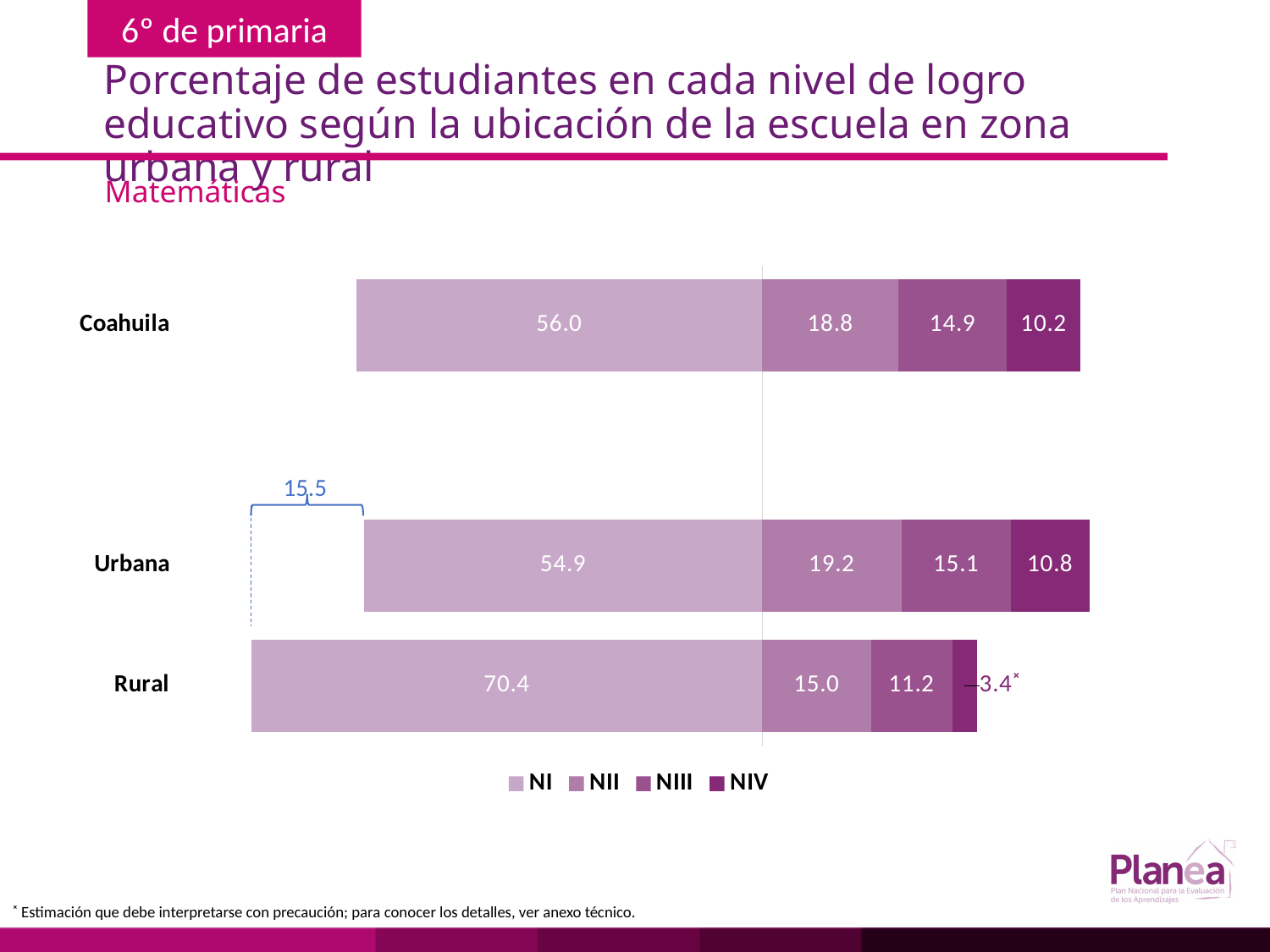
Which category has the highest NI value? Rural What is the difference between the NIV values for Urbana and Rural? 7.4 What is the NII value for Coahuila? 18.8 How many series does the legend list? 4 How many categories are shown on the chart? 3 Which category has the lowest NIV value? Rural What percentage of Rural students are at level NI? 70.4 What is the NIV value for Urbana? 10.8 What kind of chart is shown on the slide? Stacked bar chart What is the total of the stacked bar for Urbana? 100.0 Which is larger, the NIII value for Urbana or for Rural? Urbana What is the difference between the NI values for Rural and Urbana? 15.5